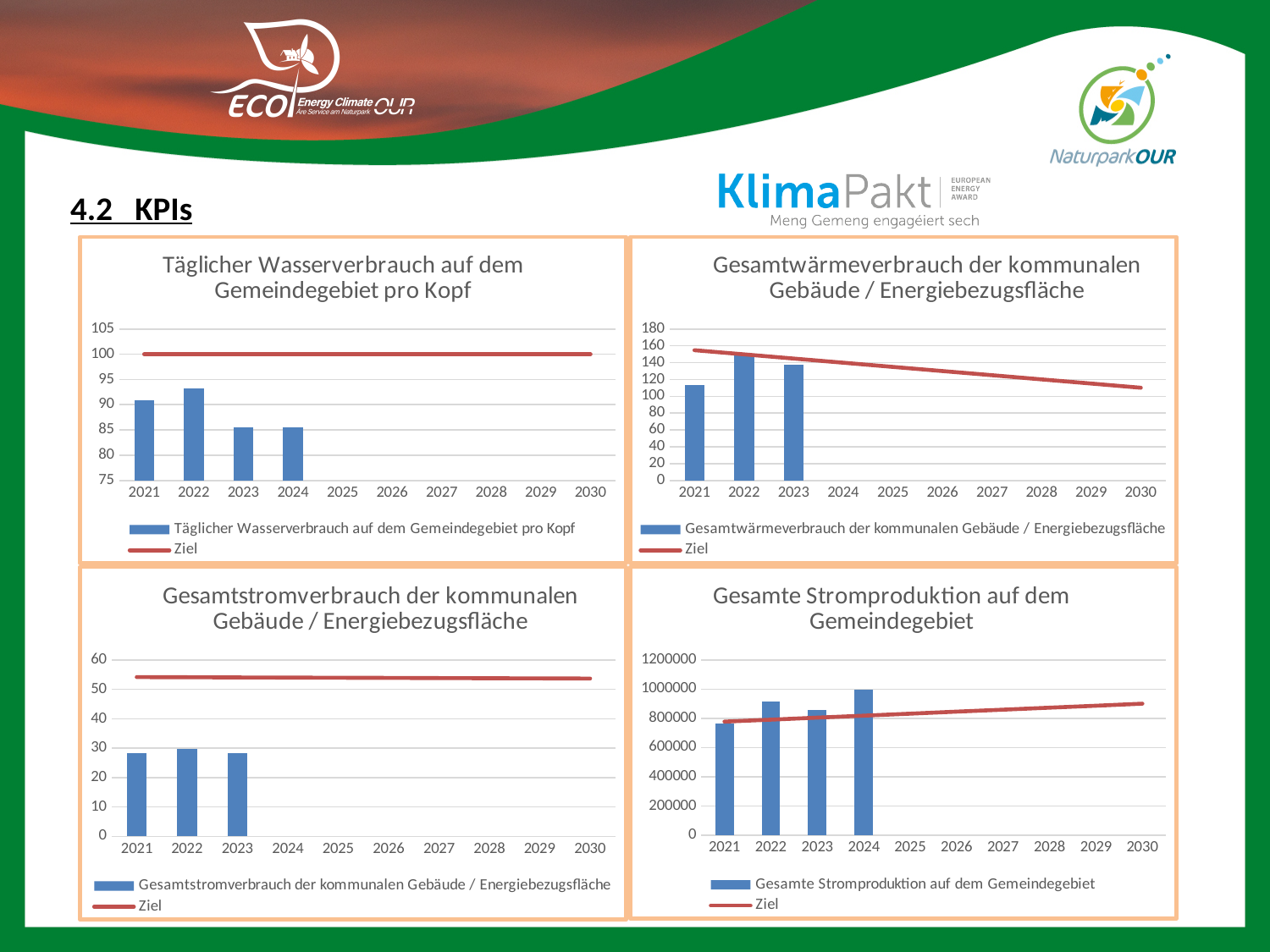
In the chart titled "Gesamte Stromproduktion auf dem Gemeindegebiet", which year has the highest bar? 2024 In the chart titled "Täglicher Wasserverbrauch auf dem Gemeindegebiet pro Kopf", which year has the highest bar? 2022 In the chart titled "Täglicher Wasserverbrauch auf dem Gemeindegebiet pro Kopf", how many series does the legend list? 2 In the chart titled "Gesamtwärmeverbrauch der kommunalen Gebäude / Energiebezugsfläche", does the Ziel line rise or fall from 2021 to 2030? fall In the chart titled "Gesamtstromverbrauch der kommunalen Gebäude / Energiebezugsfläche", is the value for 2021 greater or less than 40? less In the chart titled "Gesamtwärmeverbrauch der kommunalen Gebäude / Energiebezugsfläche", is the bar for 2022 larger or smaller than the bar for 2023? larger In the chart titled "Gesamte Stromproduktion auf dem Gemeindegebiet", does the Ziel line rise or fall from 2021 to 2030? rise In the chart titled "Gesamte Stromproduktion auf dem Gemeindegebiet", is the value for 2021 greater or less than 800000? less In the chart titled "Gesamtwärmeverbrauch der kommunalen Gebäude / Energiebezugsfläche", which year has the lowest bar? 2021 In the chart titled "Täglicher Wasserverbrauch auf dem Gemeindegebiet pro Kopf", is the value for 2023 greater or less than 90? less In the chart titled "Gesamtstromverbrauch der kommunalen Gebäude / Energiebezugsfläche", what kind of chart is used for the consumption values? bar chart In the chart titled "Gesamtwärmeverbrauch der kommunalen Gebäude / Energiebezugsfläche", how many years have a bar plotted? 3